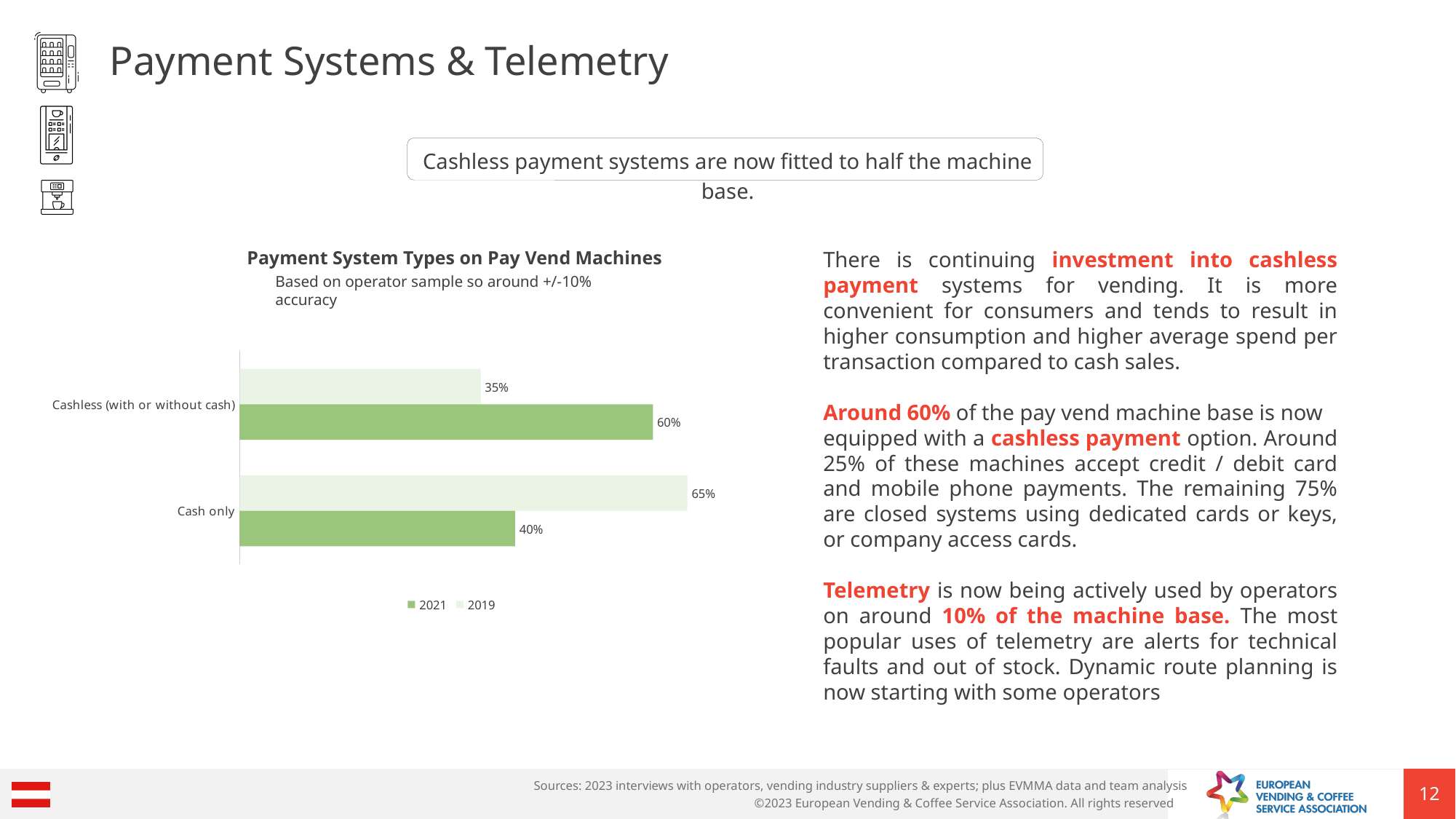
What kind of chart is shown on the slide? Bar chart What is the 2021 value for Cashless (with or without cash)? 60% What is the 2021 value for Cash only? 40% What is the title of the chart? Payment System Types on Pay Vend Machines How many categories are shown in the chart? 2 What is the difference between the 2021 and 2019 values for Cashless (with or without cash)? 25% Which category has the highest 2019 value? Cash only Which category has the lowest 2021 value? Cash only What is the 2019 value for Cash only? 65% Which is larger for Cash only: the 2021 value or the 2019 value? 2019 How many series does the legend list? 2 What is the 2019 value for Cashless (with or without cash)? 35%